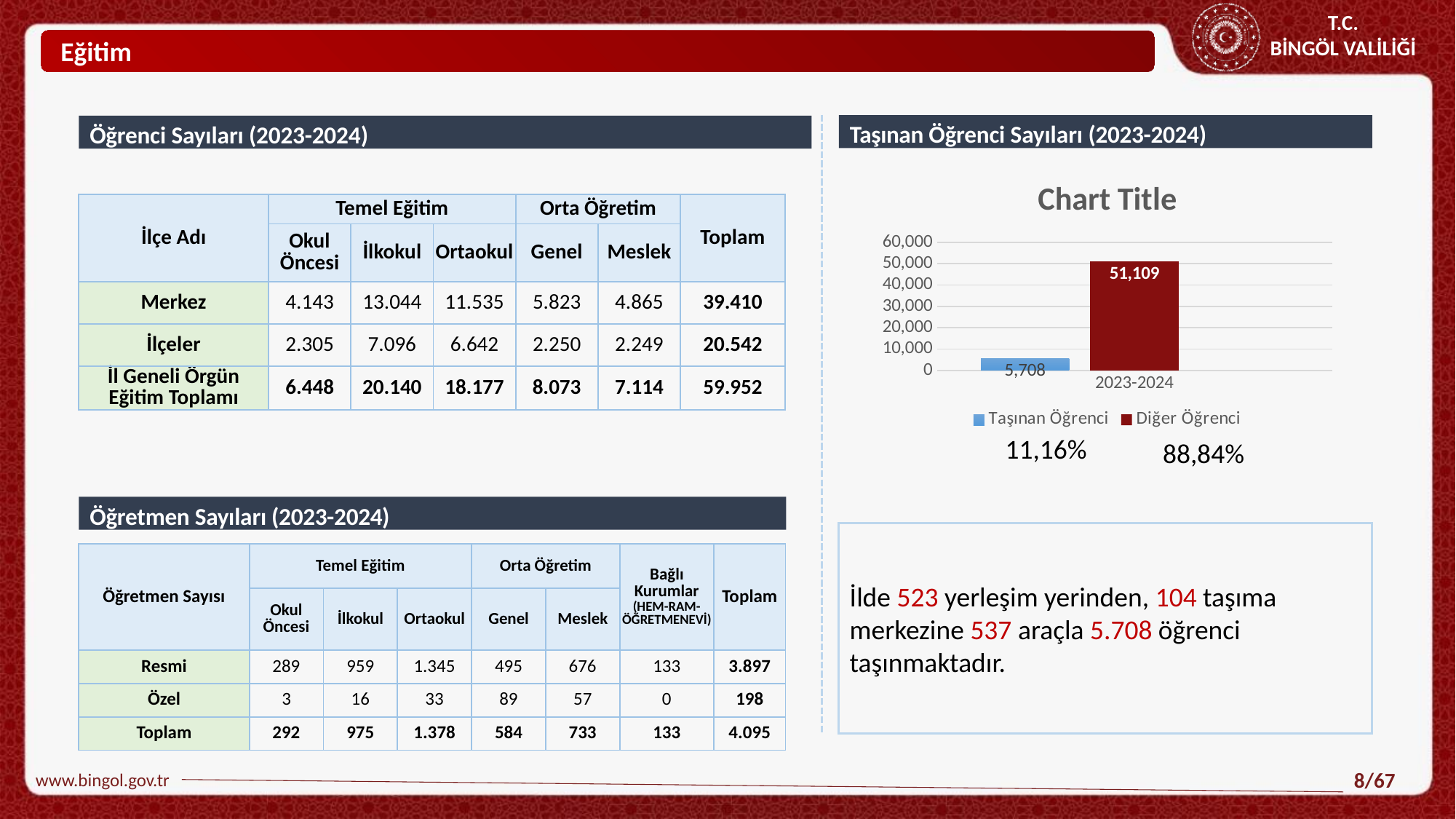
What is the value for Taşınan Öğrenci in the chart? 5,708 What is the highest value shown on the chart's y axis? 60,000 Is the value for Taşınan Öğrenci greater or less than 10,000? less What category label is shown on the x axis of the chart? 2023-2024 Which series has the higher value in the chart, Taşınan Öğrenci or Diğer Öğrenci? Diğer Öğrenci What is the value for Diğer Öğrenci in the chart? 51,109 What type of chart is shown on the slide? bar chart What is the difference between the Diğer Öğrenci and Taşınan Öğrenci values in the chart? 45,401 Is the value for Diğer Öğrenci greater or less than 50,000? greater Which series has the lowest value in the chart? Taşınan Öğrenci What is the title shown above the chart? Chart Title How many series does the chart legend list? 2